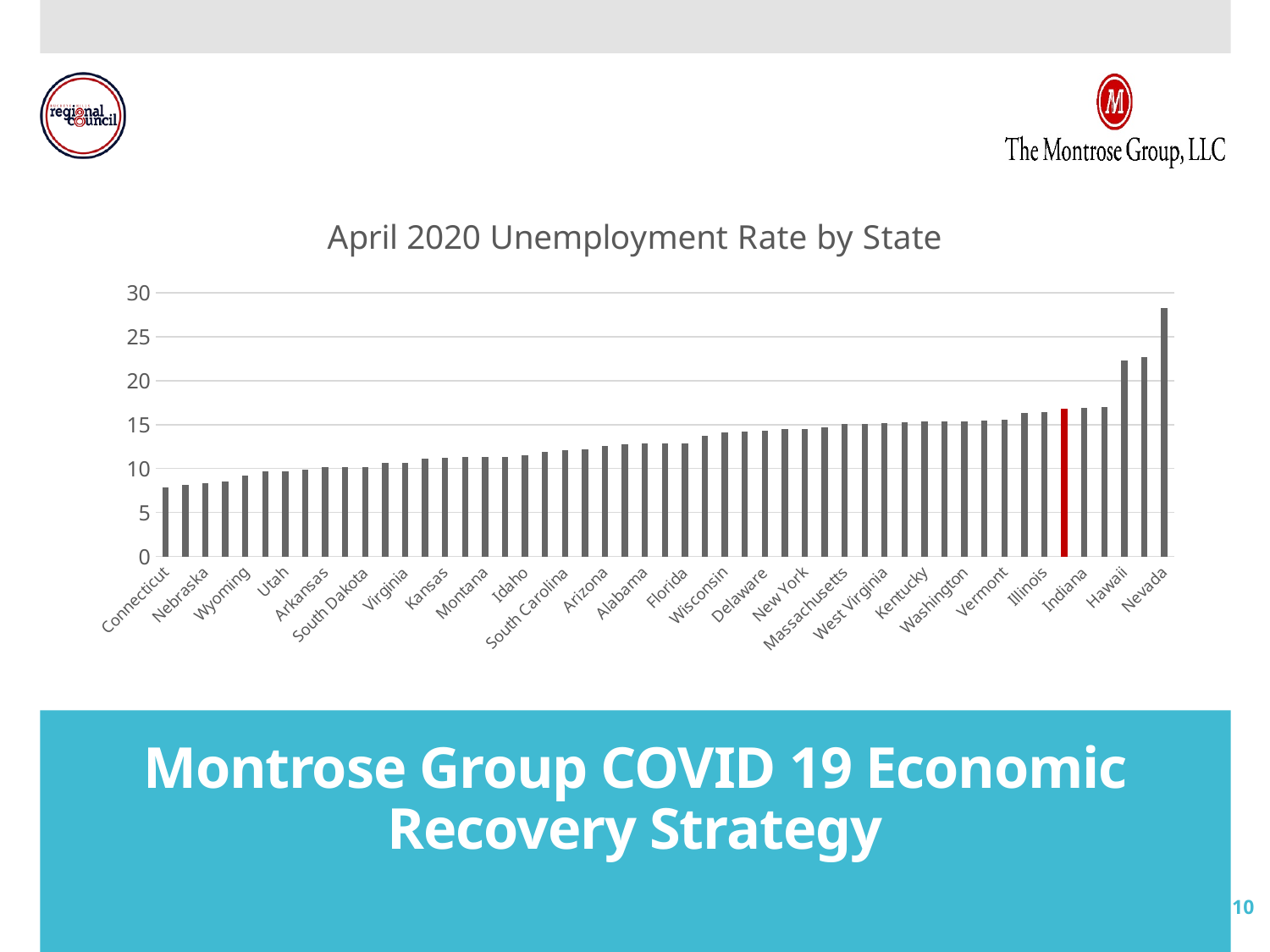
Is the value for Nevada greater or less than 25? greater Is the value for Connecticut greater or less than 10? less Is the value for Hawaii greater or less than 20? greater What kind of chart is shown on the slide? Bar chart Which state has the lowest unemployment rate in the chart? Connecticut What is the title of the chart? April 2020 Unemployment Rate by State Which state has the highest unemployment rate in the chart? Nevada Do the values rise or fall moving from left to right along the x axis? Rise Which state has a higher unemployment rate, Hawaii or Florida? Hawaii Which state's bar is highlighted in red? Indiana